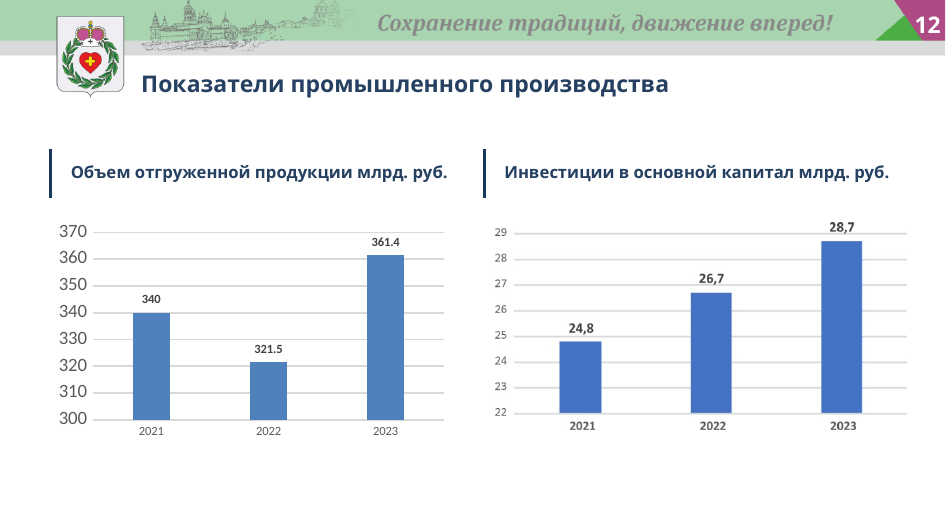
In the chart 'Объем отгруженной продукции млрд. руб.', which year has the highest value? 2023 In the chart 'Объем отгруженной продукции млрд. руб.', which year has the lowest value? 2022 In the chart 'Инвестиции в основной капитал млрд. руб.', do the values rise or fall from 2021 to 2023? rise What type of chart is 'Инвестиции в основной капитал млрд. руб.'? bar chart In the chart 'Инвестиции в основной капитал млрд. руб.', what is the value for 2021? 24,8 In the chart 'Объем отгруженной продукции млрд. руб.', what is the value for 2023? 361.4 In the chart 'Инвестиции в основной капитал млрд. руб.', which year has the highest value? 2023 In the chart 'Инвестиции в основной капитал млрд. руб.', what is the value for 2022? 26,7 How many years are shown in the chart 'Объем отгруженной продукции млрд. руб.'? 3 In the chart 'Инвестиции в основной капитал млрд. руб.', what is the difference between the 2023 and 2021 values? 3,9 In the chart 'Объем отгруженной продукции млрд. руб.', what is the value for 2022? 321.5 In the chart 'Объем отгруженной продукции млрд. руб.', what is the difference between the 2023 and 2021 values? 21.4